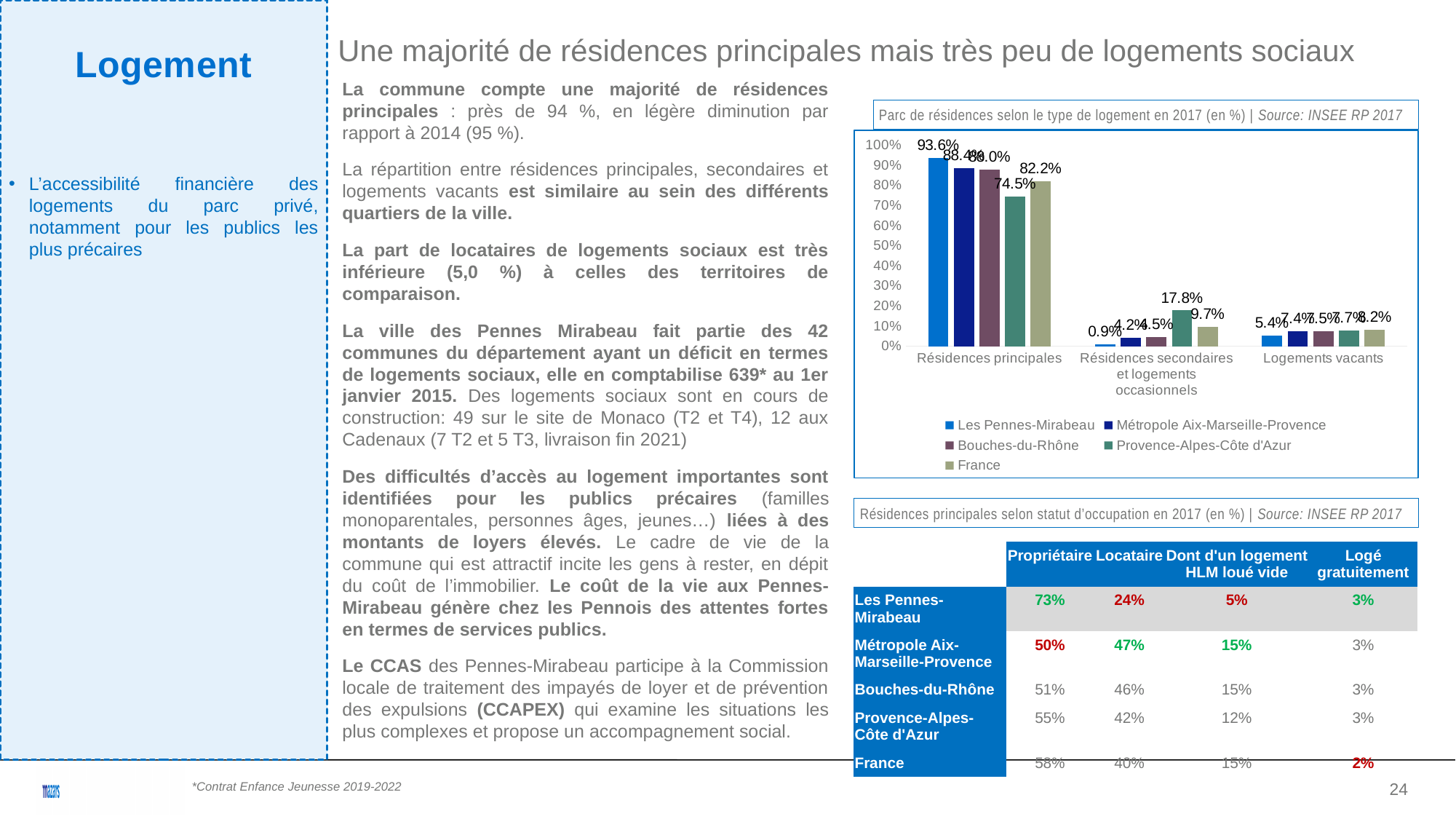
In the chart 'Parc de résidences selon le type de logement en 2017', what is the value for France in the 'Résidences principales' category? 82.2% In the chart 'Parc de résidences selon le type de logement en 2017', which series has the highest value for 'Résidences principales'? Les Pennes-Mirabeau In the chart 'Parc de résidences selon le type de logement en 2017', what is the difference between Les Pennes-Mirabeau and Provence-Alpes-Côte d'Azur for 'Résidences principales'? 19.1 percentage points How many series does the legend of the chart 'Parc de résidences selon le type de logement en 2017' list? 5 In the chart 'Parc de résidences selon le type de logement en 2017', what is the value for Les Pennes-Mirabeau in the 'Résidences principales' category? 93.6% In the chart 'Parc de résidences selon le type de logement en 2017', what is the value for Provence-Alpes-Côte d'Azur in the 'Résidences principales' category? 74.5% In the chart 'Parc de résidences selon le type de logement en 2017', which series has the lowest value for 'Résidences principales'? Provence-Alpes-Côte d'Azur What kind of chart is 'Parc de résidences selon le type de logement en 2017'? Bar chart In the chart 'Parc de résidences selon le type de logement en 2017', what is the value for Provence-Alpes-Côte d'Azur in the 'Résidences secondaires et logements occasionnels' category? 17.8% In the chart 'Parc de résidences selon le type de logement en 2017', is the value for Métropole Aix-Marseille-Provence in 'Résidences principales' greater or less than 80%? greater In the chart 'Parc de résidences selon le type de logement en 2017', what is the value for Les Pennes-Mirabeau in the 'Résidences secondaires et logements occasionnels' category? 0.9% In the chart 'Parc de résidences selon le type de logement en 2017', which is larger for 'Logements vacants': Les Pennes-Mirabeau or France? France